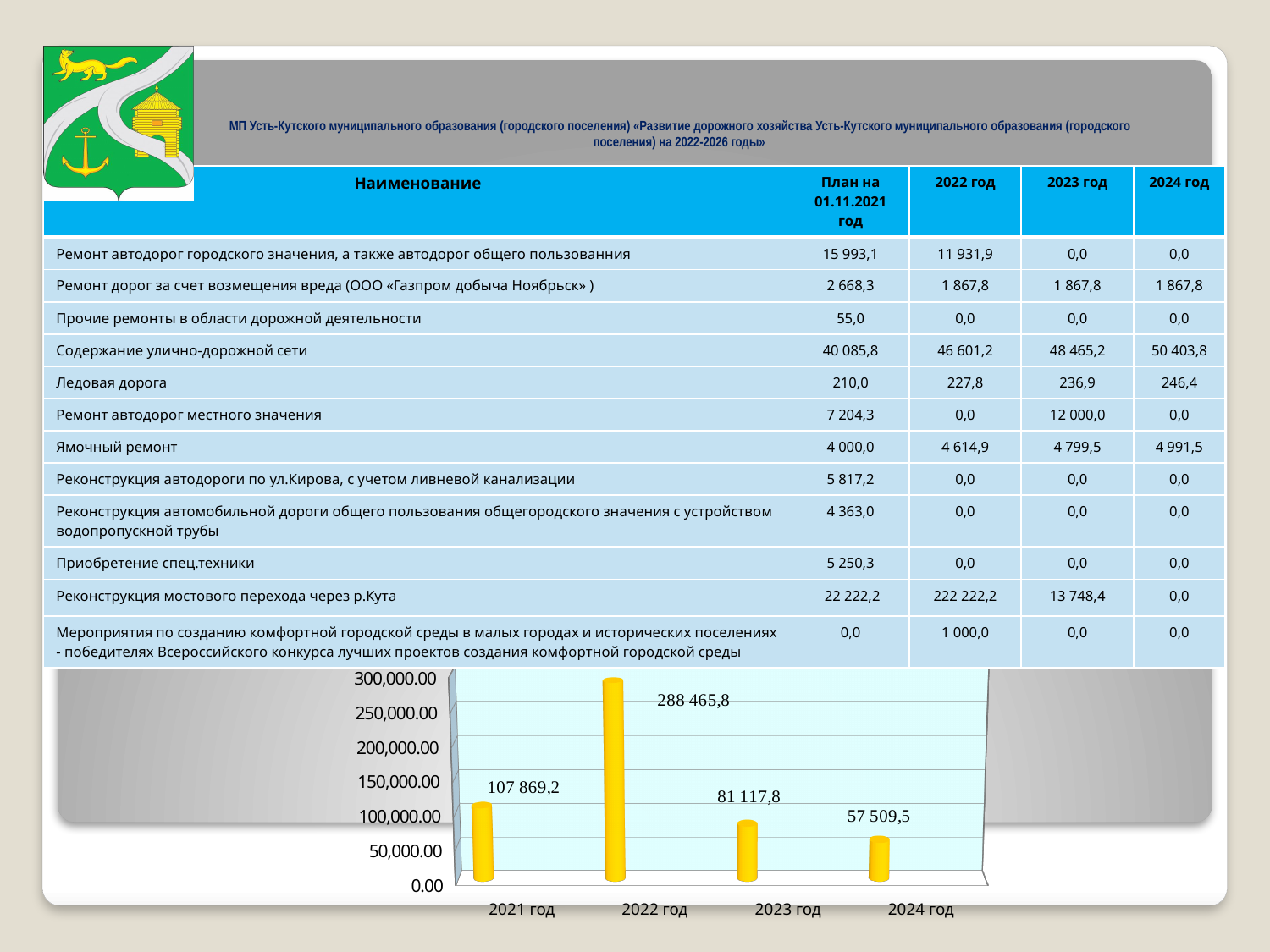
Which is larger on the chart, the value for 2021 год or the value for 2023 год? 2021 год Which year has the highest value on the chart? 2022 год How many categories (years) are plotted on the chart? 4 Do the values on the chart rise or fall from 2022 год to 2024 год? fall What is the value shown for 2022 год on the chart? 288 465,8 What is the value shown for 2023 год on the chart? 81 117,8 Is the value for 2022 год greater or less than 250,000.00? greater What is the value shown for 2024 год on the chart? 57 509,5 What kind of chart is shown at the bottom of the slide? bar chart What is the difference between the values for 2022 год and 2023 год on the chart? 207 348,0 What is the value shown for 2021 год on the chart? 107 869,2 Which year has the lowest value on the chart? 2024 год